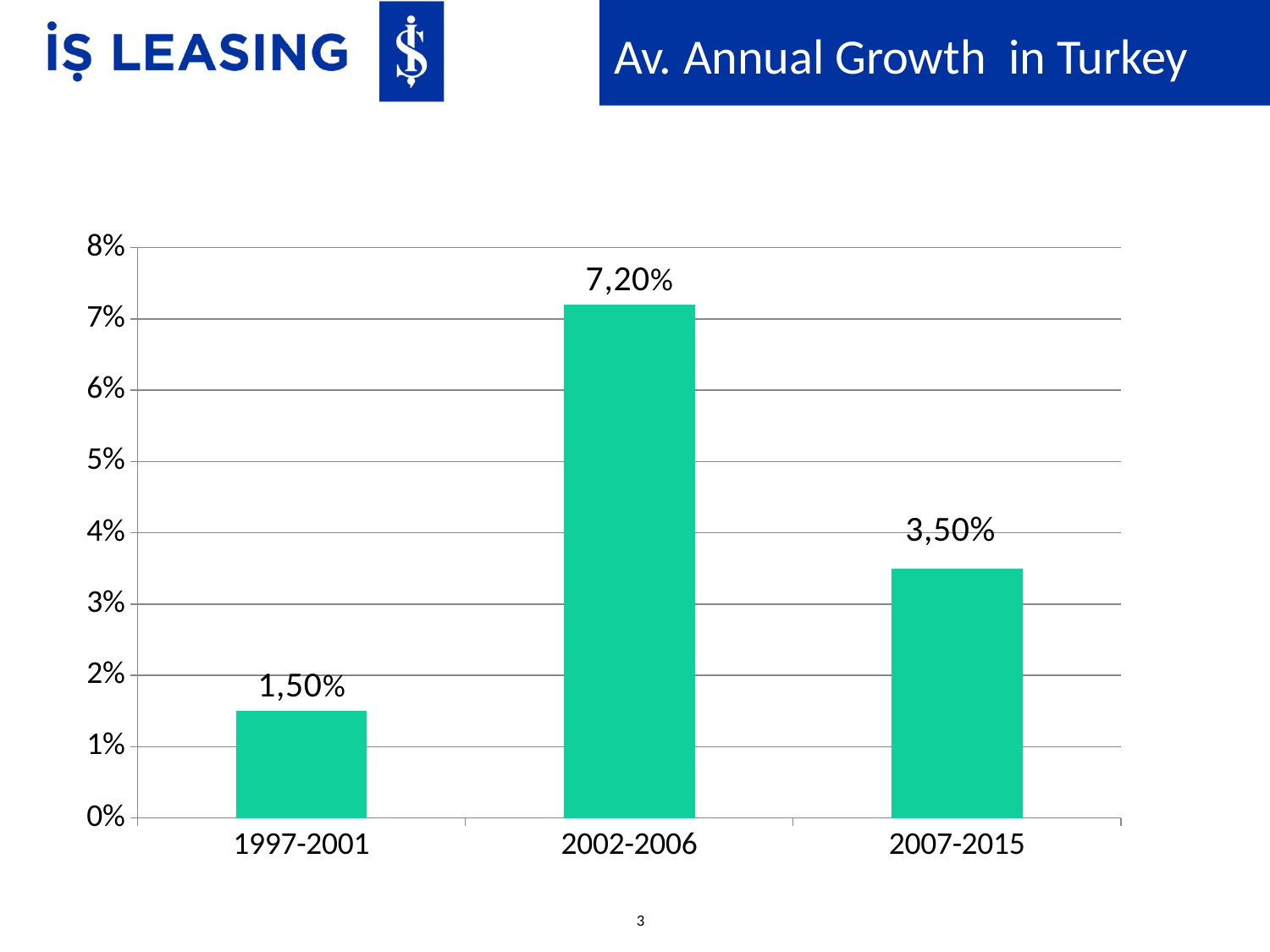
What is the value shown for the 1997-2001 period? 1,50% Which period has the highest average annual growth? 2002-2006 What is the average annual growth value shown for 2002-2006? 7,20% What is the value shown for the 2007-2015 period? 3,50% What is the difference between the values for 2007-2015 and 1997-2001? 2,00% Is the value for 2002-2006 greater or less than 5%? greater Which is larger, the value for 2007-2015 or the value for 1997-2001? 2007-2015 What is the title shown in the header of the slide? Av. Annual Growth in Turkey What is the difference between the values for 2002-2006 and 2007-2015? 3,70% How many periods are shown on the x axis? 3 What kind of chart is shown on the slide? Bar chart Which period has the lowest average annual growth? 1997-2001